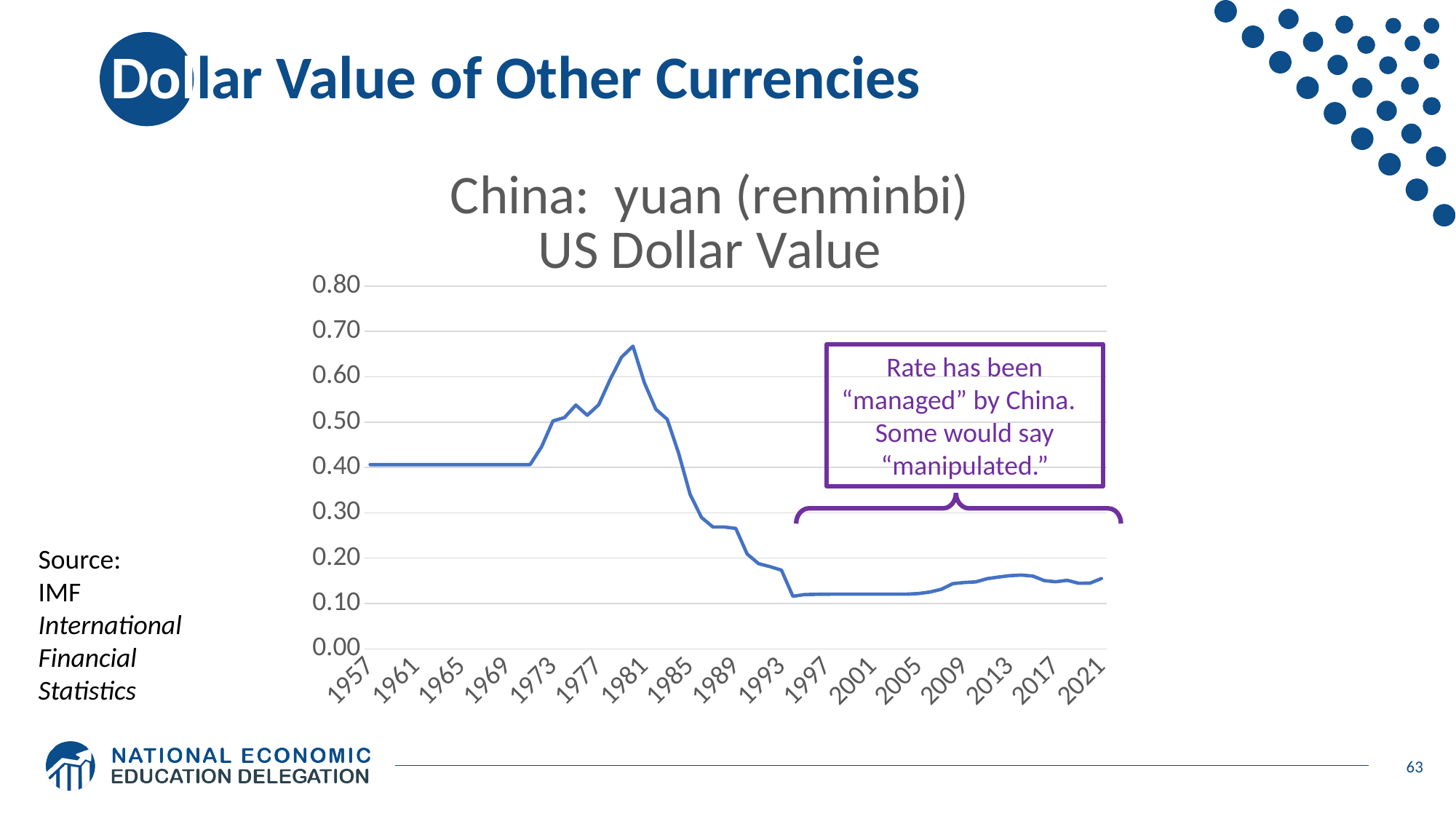
What is the title of the chart? China: yuan (renminbi) US Dollar Value Is the value for 1997 greater or less than 0.20? less Is the value for 1977 greater or less than 0.50? greater Does the value rise or fall between 1981 and 1993? fall Is the value for 2021 greater or less than 0.20? less What kind of chart is shown on the slide? line chart How many year labels are shown on the x axis? 17 Does the value rise or fall between 1969 and 1981? rise What is the highest value shown on the y axis? 0.80